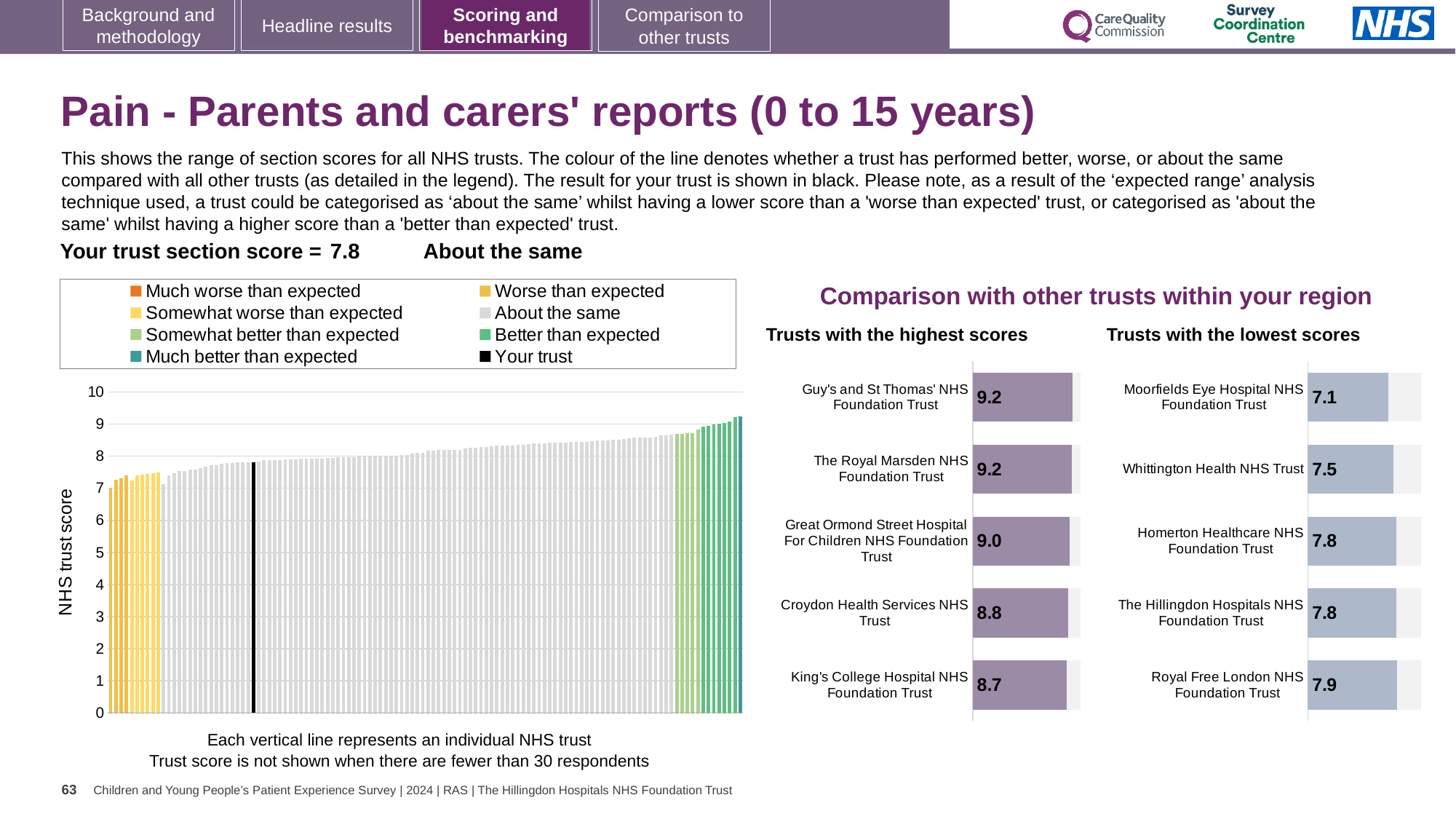
What is your trust's section score shown on the slide? 7.8 What kind of chart is the large chart on the left showing NHS trust scores? Bar chart In the left-hand NHS trust score chart, is the value of the tallest bar greater or less than 9? greater In the left-hand NHS trust score chart, do the bar values rise or fall from left to right? Rise In the 'Trusts with the lowest scores' chart, what is the difference between the score for Royal Free London NHS Foundation Trust and the score for Moorfields Eye Hospital NHS Foundation Trust? 0.8 How many entries does the legend of the left-hand NHS trust score chart list? 8 Which has the higher score: Croydon Health Services NHS Trust in the 'highest scores' chart or Homerton Healthcare NHS Foundation Trust in the 'lowest scores' chart? Croydon Health Services NHS Trust In the 'Trusts with the highest scores' chart, what is the difference between the score for Guy's and St Thomas' NHS Foundation Trust and the score for King's College Hospital NHS Foundation Trust? 0.5 In the 'Trusts with the highest scores' chart, what is the score for Great Ormond Street Hospital For Children NHS Foundation Trust? 9.0 How many trusts are shown in the 'Trusts with the highest scores' chart? 5 In the 'Trusts with the lowest scores' chart, what is the score for Whittington Health NHS Trust? 7.5 In the 'Trusts with the lowest scores' chart, which trust has the lowest score? Moorfields Eye Hospital NHS Foundation Trust